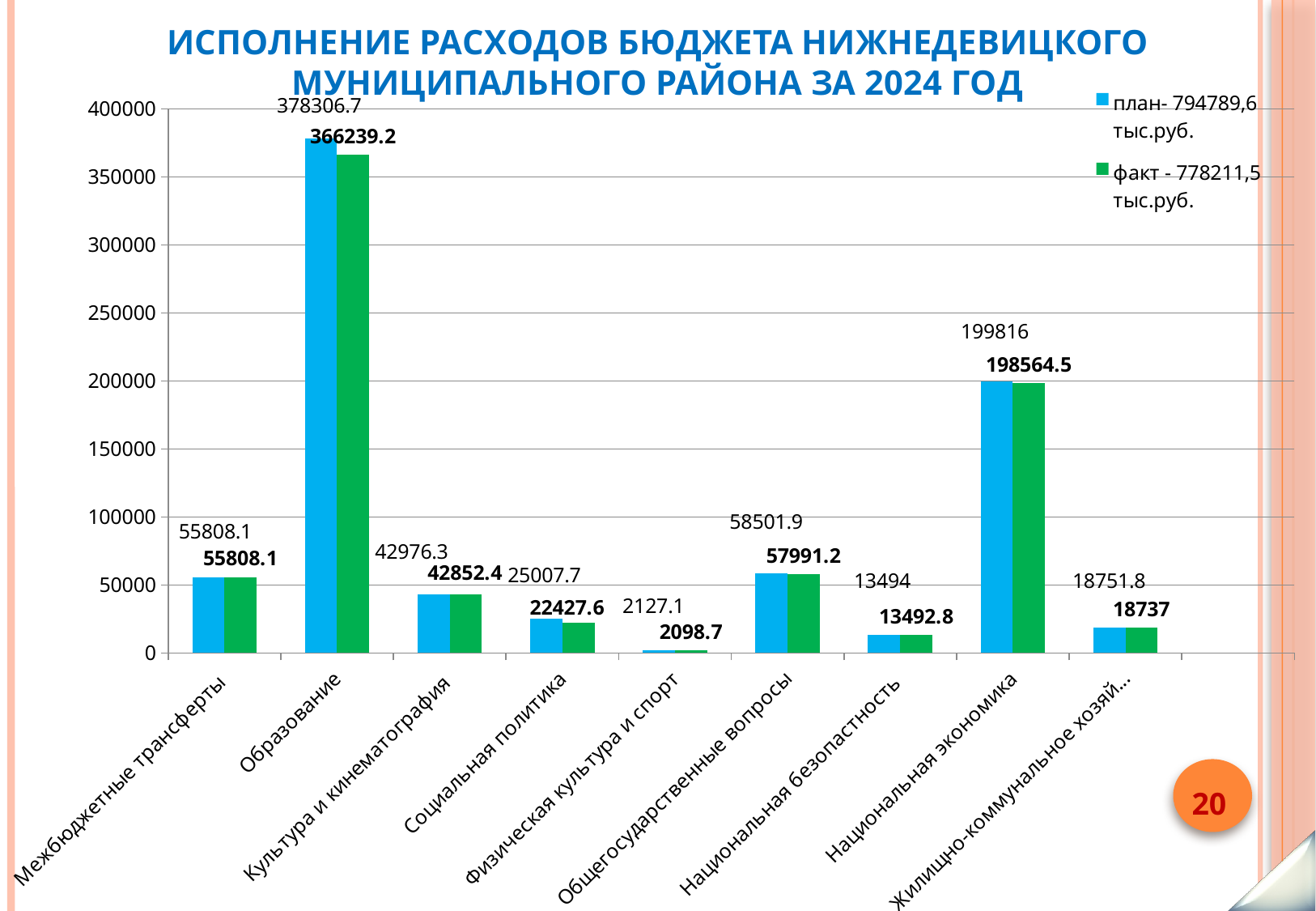
What is the факт value for Национальная экономика? 198564.5 Which category has the lowest план value? Физическая культура и спорт Is the факт value for Образование greater or less than 350000? greater What is the difference between the план and факт values for Социальная политика? 2580.1 What is the difference between the план and факт values for Образование? 12067.5 How many series does the legend list? 2 What is the факт value for Социальная политика? 22427.6 Which is larger: the план value for Национальная экономика or the план value for Образование? Образование Which category has the highest факт value? Образование What is the план value for Образование? 378306.7 How many categories are shown on the x axis? 9 What is the план value for Национальная безопасность? 13494